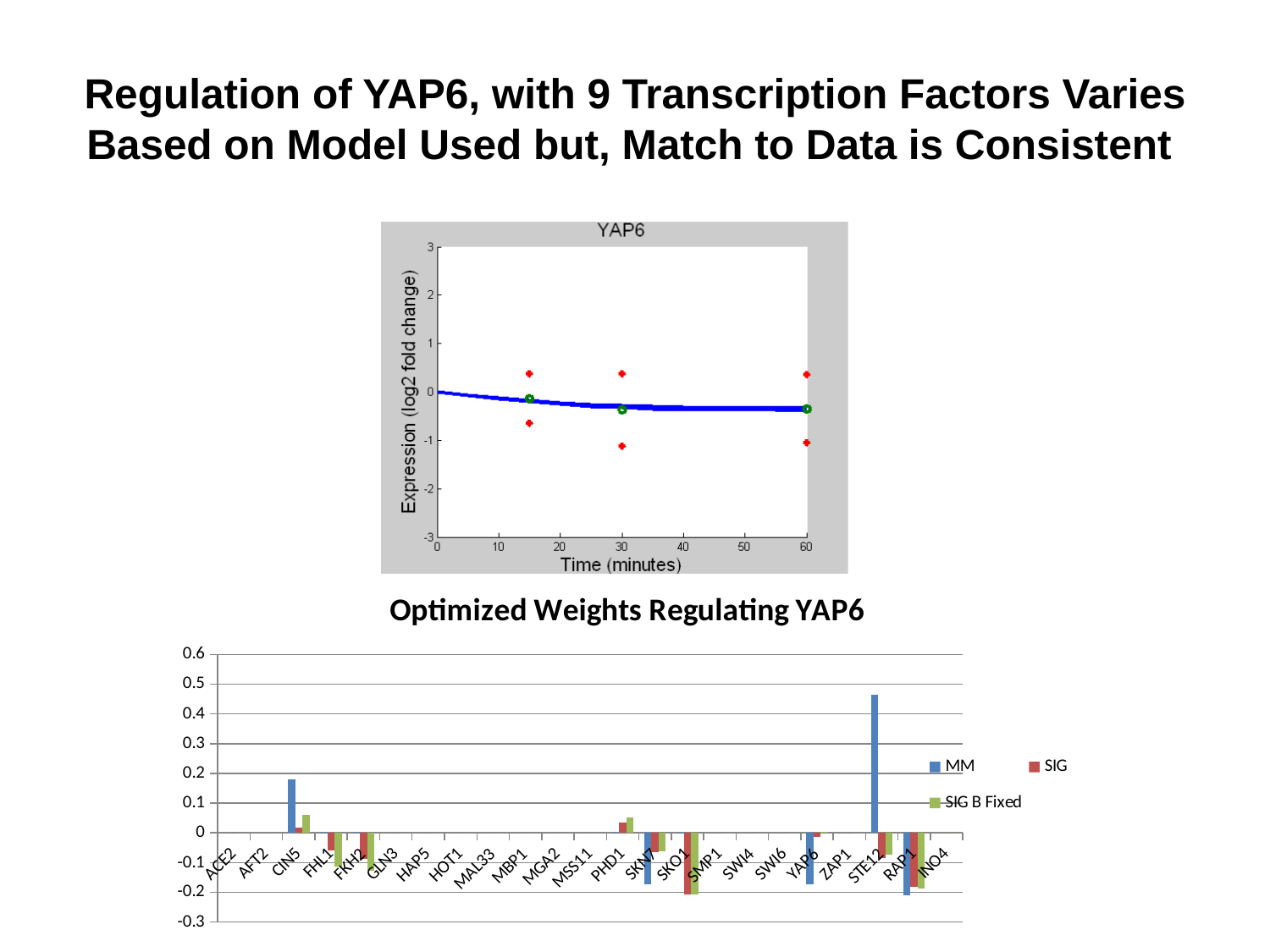
In the bottom chart 'Optimized Weights Regulating YAP6', what kind of chart is it? bar chart In the top chart titled 'YAP6', what is the label of the y axis? Expression (log2 fold change) In the bottom chart 'Optimized Weights Regulating YAP6', which is larger, the MM value for STE12 or the MM value for CIN5? STE12 In the bottom chart 'Optimized Weights Regulating YAP6', which category has the highest MM value? STE12 In the bottom chart 'Optimized Weights Regulating YAP6', how many transcription factor categories are shown on the x axis? 23 In the bottom chart 'Optimized Weights Regulating YAP6', how many series does the legend list? 3 In the bottom chart 'Optimized Weights Regulating YAP6', is the SIG value for SKO1 greater or less than -0.1? less In the top chart titled 'YAP6', does the blue model curve rise or fall from time 0 to time 60? fall In the bottom chart 'Optimized Weights Regulating YAP6', is the MM value for CIN5 greater or less than 0.1? greater In the bottom chart 'Optimized Weights Regulating YAP6', is the MM value for STE12 greater or less than 0.3? greater In the bottom chart 'Optimized Weights Regulating YAP6', what are the series names in the legend? MM, SIG, SIG B Fixed In the top chart titled 'YAP6', what is the largest time value shown on the x axis? 60